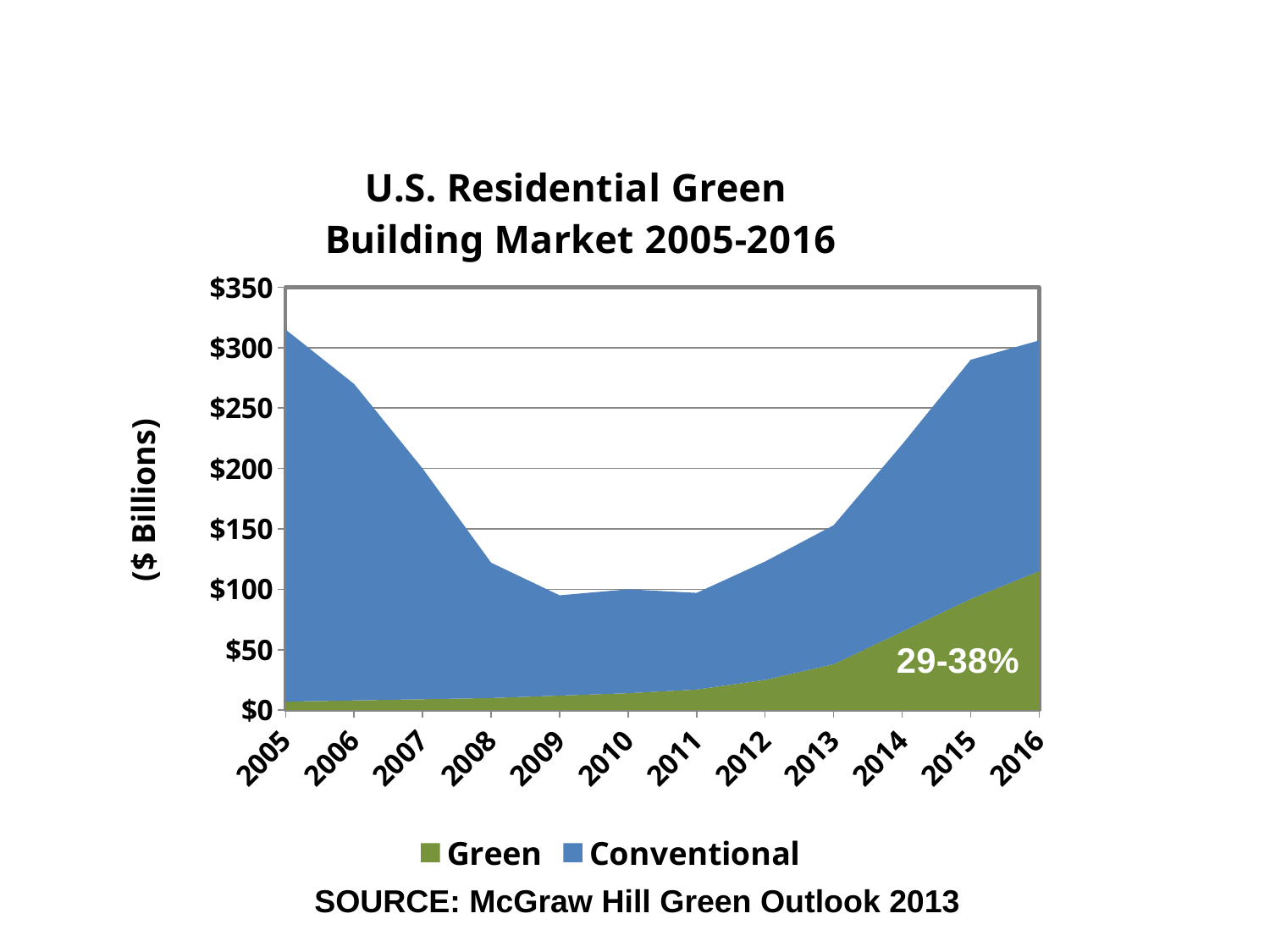
What kind of chart is shown on the slide? Stacked area chart Is the Green value in 2016 greater or less than $100 billion? greater Is the total market value in 2015 greater or less than $250 billion? greater Is the total market value in 2008 greater or less than $150 billion? less Does the total market value rise or fall from 2005 to 2009? fall Which year has the lowest value for the Green series? 2005 How many years are shown along the x axis? 12 How many series does the legend list? 2 Does the Green series rise or fall from 2011 to 2016? rise What is the label on the y axis? ($ Billions) Which year has the highest value for the Green series? 2016